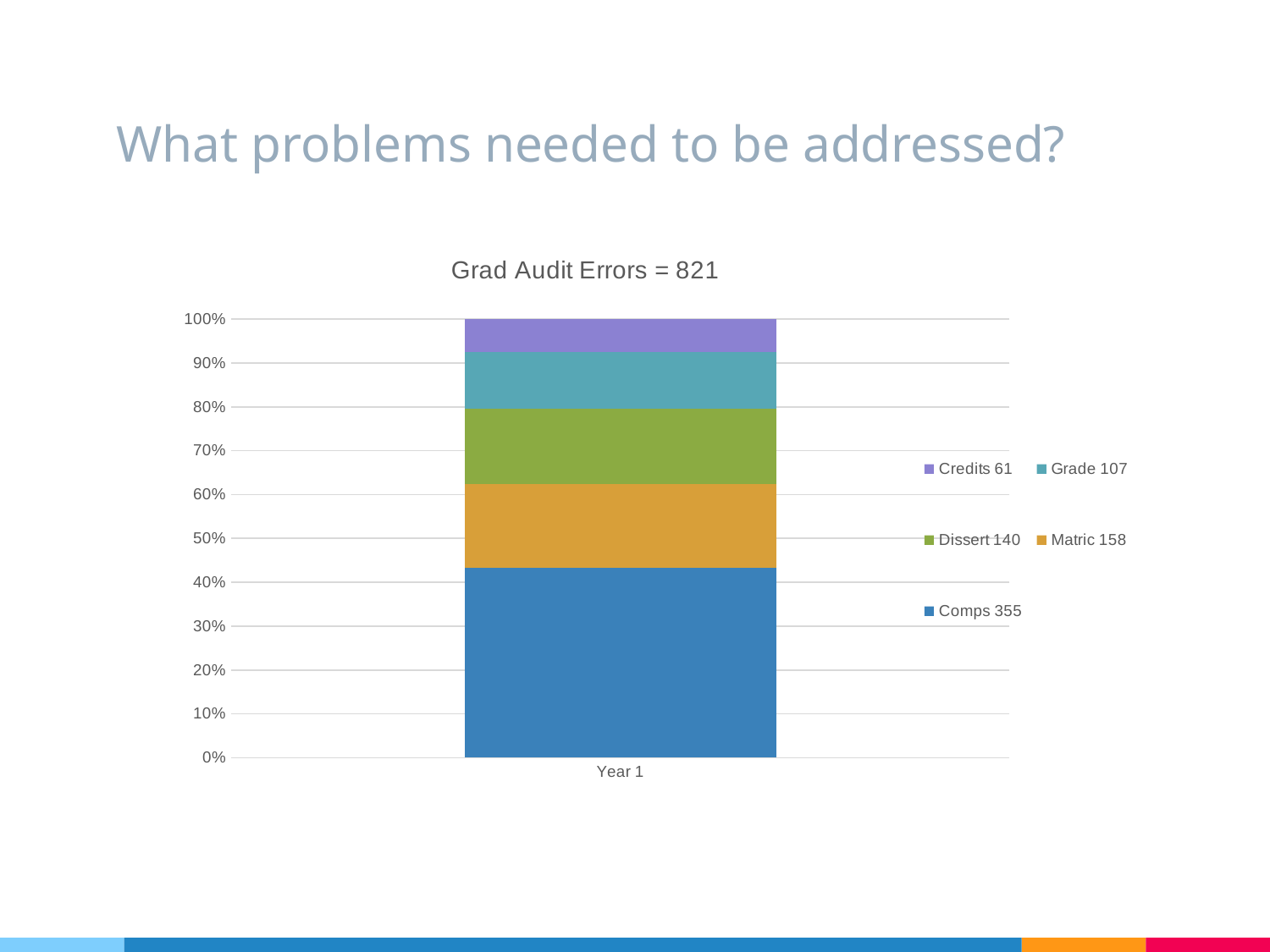
What is the title of the chart? Grad Audit Errors = 821 How many categories are shown on the x axis? 1 What is the number of errors for Credits according to the legend? 61 What is the number of errors for Comps according to the legend? 355 Which series has the lowest number of errors? Credits How many series does the legend list? 5 Is the share of the Year 1 bar taken by Comps greater or less than 50%? less What is the difference between the Matric and Dissert error counts? 18 Which series has the highest number of errors? Comps What kind of chart is shown on the slide? stacked bar chart Which has more errors, Grade or Dissert? Dissert What is the number of errors for Matric according to the legend? 158